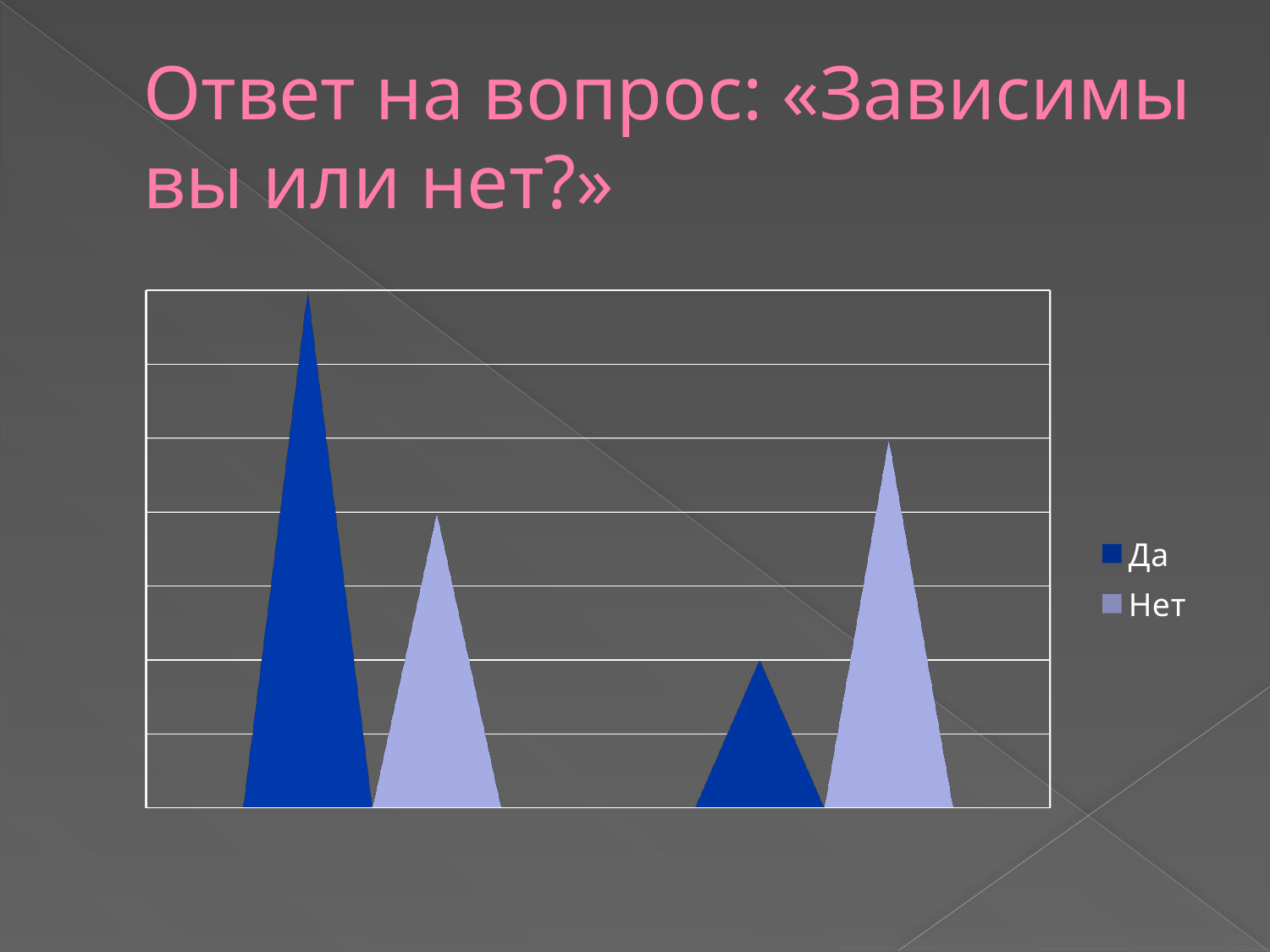
Which series is shown in dark blue in the legend? Да Does the Да series rise or fall from the left group to the right group? fall In the right group of bars, which series is larger, Да or Нет? Нет What kind of chart is shown on the slide? bar chart Which series has the shortest bar on the chart? Да In the left group of bars, which series is larger, Да or Нет? Да How many series does the legend list? 2 Does the Нет series rise or fall from the left group to the right group? rise What are the two series named in the legend? Да and Нет Which series has the tallest bar on the chart? Да How many groups of bars are plotted on the chart? 2